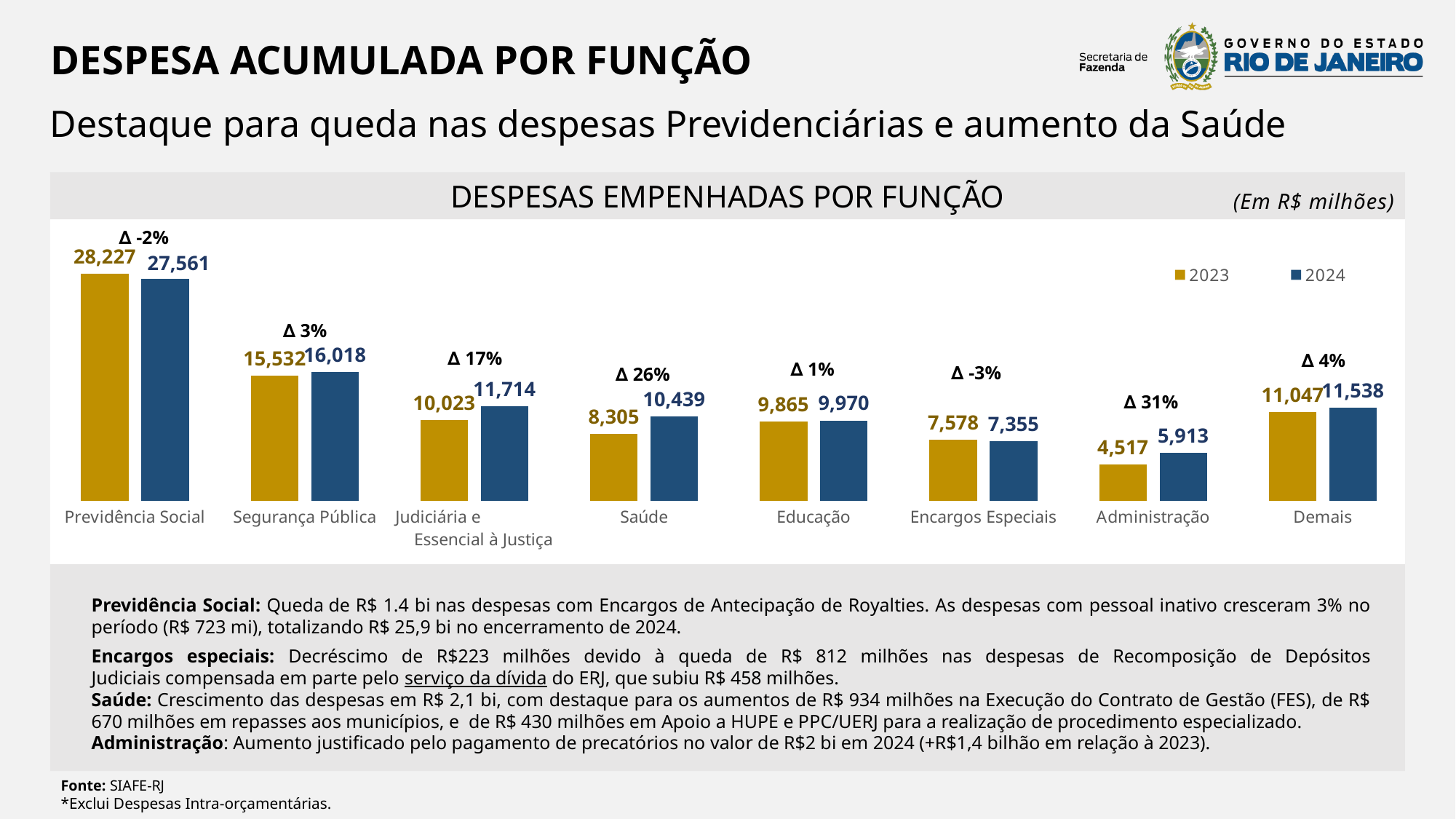
What is the difference between the 2023 and 2024 values for Previdência Social? 666 What is the 2023 value for Administração? 4,517 How many categories are shown on the x axis? 8 What is the 2024 value for Segurança Pública? 16,018 What kind of chart is shown? Bar chart What is the difference between the 2024 and 2023 values for Saúde? 2,134 Which category has the lowest 2023 value? Administração Which is larger for Encargos Especiais, the 2023 value or the 2024 value? 2023 What percentage change (Δ) is shown above the Administração bars? Δ 31% Which category has the highest 2024 value? Previdência Social What is the 2024 value for Saúde? 10,439 How many series does the legend list? 2